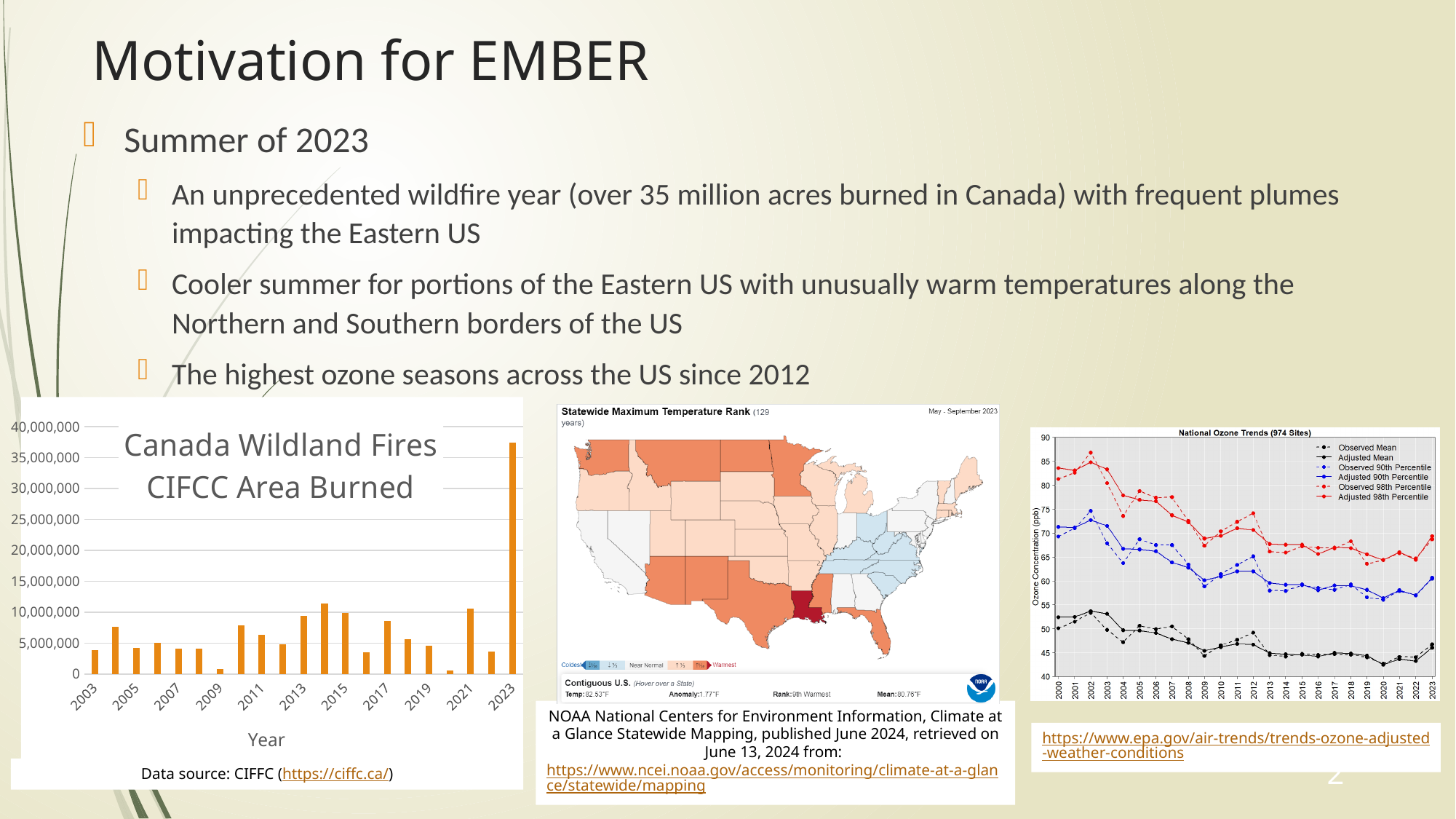
In the National Ozone Trends (974 Sites) chart, does the Observed Mean series generally rise or fall from 2000 to 2023? fall How many series does the legend of the National Ozone Trends (974 Sites) chart list? 6 What kind of chart is the National Ozone Trends (974 Sites) chart? line chart What kind of chart is the Canada Wildland Fires CIFCC Area Burned chart? bar chart What is the x-axis title of the Canada Wildland Fires CIFCC Area Burned chart? Year In the Canada Wildland Fires CIFCC Area Burned chart, is the value for 2023 greater or less than 35,000,000? greater In the National Ozone Trends (974 Sites) chart, is the Observed 98th Percentile value for 2000 greater or less than 80? greater In the Canada Wildland Fires CIFCC Area Burned chart, which year has the larger area burned, 2014 or 2017? 2014 How many yearly bars are plotted in the Canada Wildland Fires CIFCC Area Burned chart? 21 In the Canada Wildland Fires CIFCC Area Burned chart, is the value for 2014 greater or less than 10,000,000? greater In the Canada Wildland Fires CIFCC Area Burned chart, which year has the highest area burned? 2023